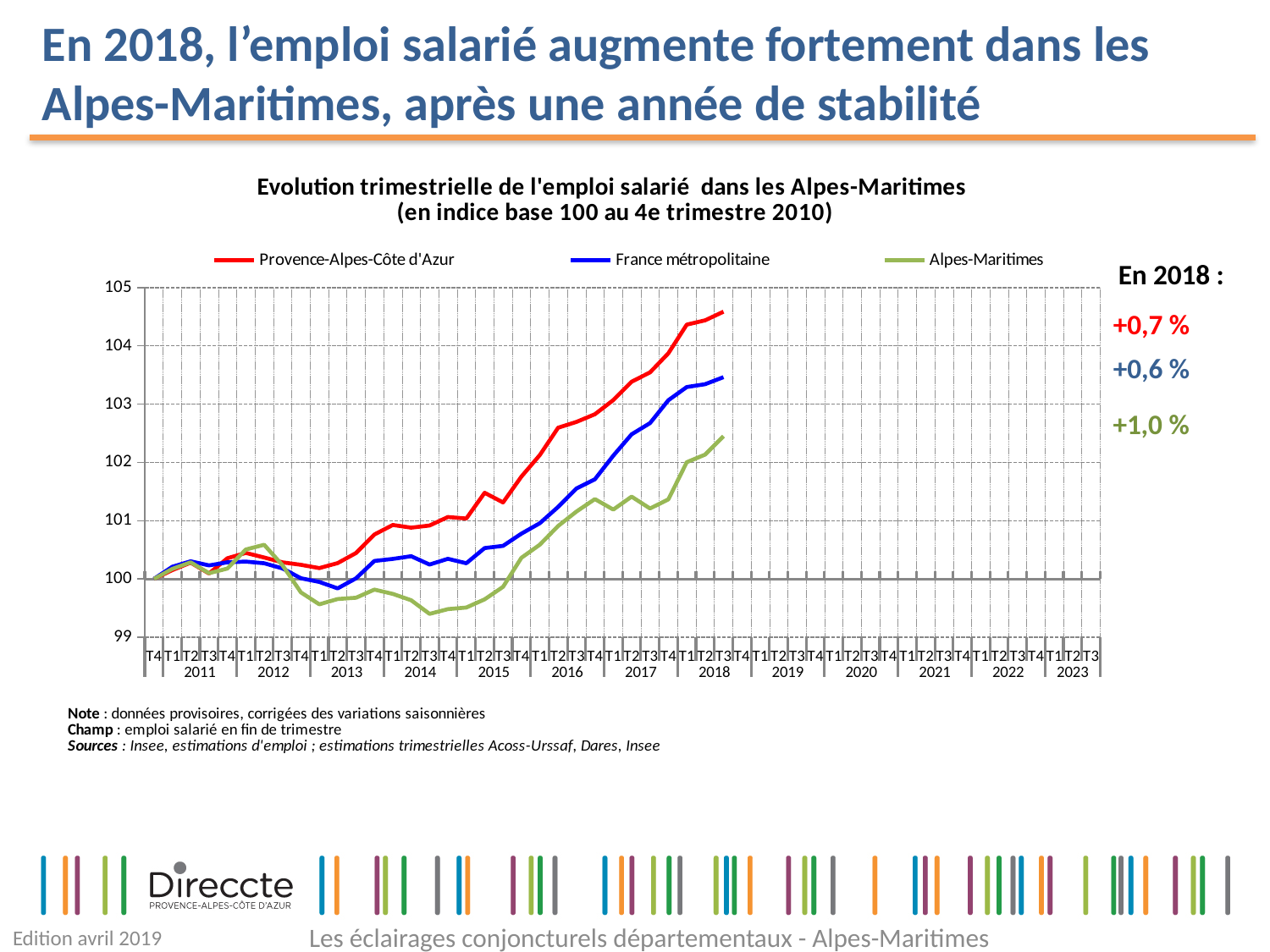
What is the base period of the index according to the chart title? 4e trimestre 2010 According to the annotation on the right, what was the change in 2018 for Alpes-Maritimes? +1,0 % Does the Alpes-Maritimes series rise or fall between 2015 and 2018? rise Is the value for France métropolitaine at T3 2018 greater or less than 103? greater Is the value for Provence-Alpes-Côte d'Azur at T3 2018 greater or less than 104? greater What kind of chart is shown on the slide? line chart Which series has the highest value at the last plotted point (T3 2018)? Provence-Alpes-Côte d'Azur Which series has the lowest value at the last plotted point (T3 2018)? Alpes-Maritimes Is the value for Alpes-Maritimes at T3 2014 greater or less than 100? less How many series does the legend list? 3 According to the annotation on the right, what was the change in 2018 for France métropolitaine? +0,6 % Which series is drawn in red in the legend? Provence-Alpes-Côte d'Azur